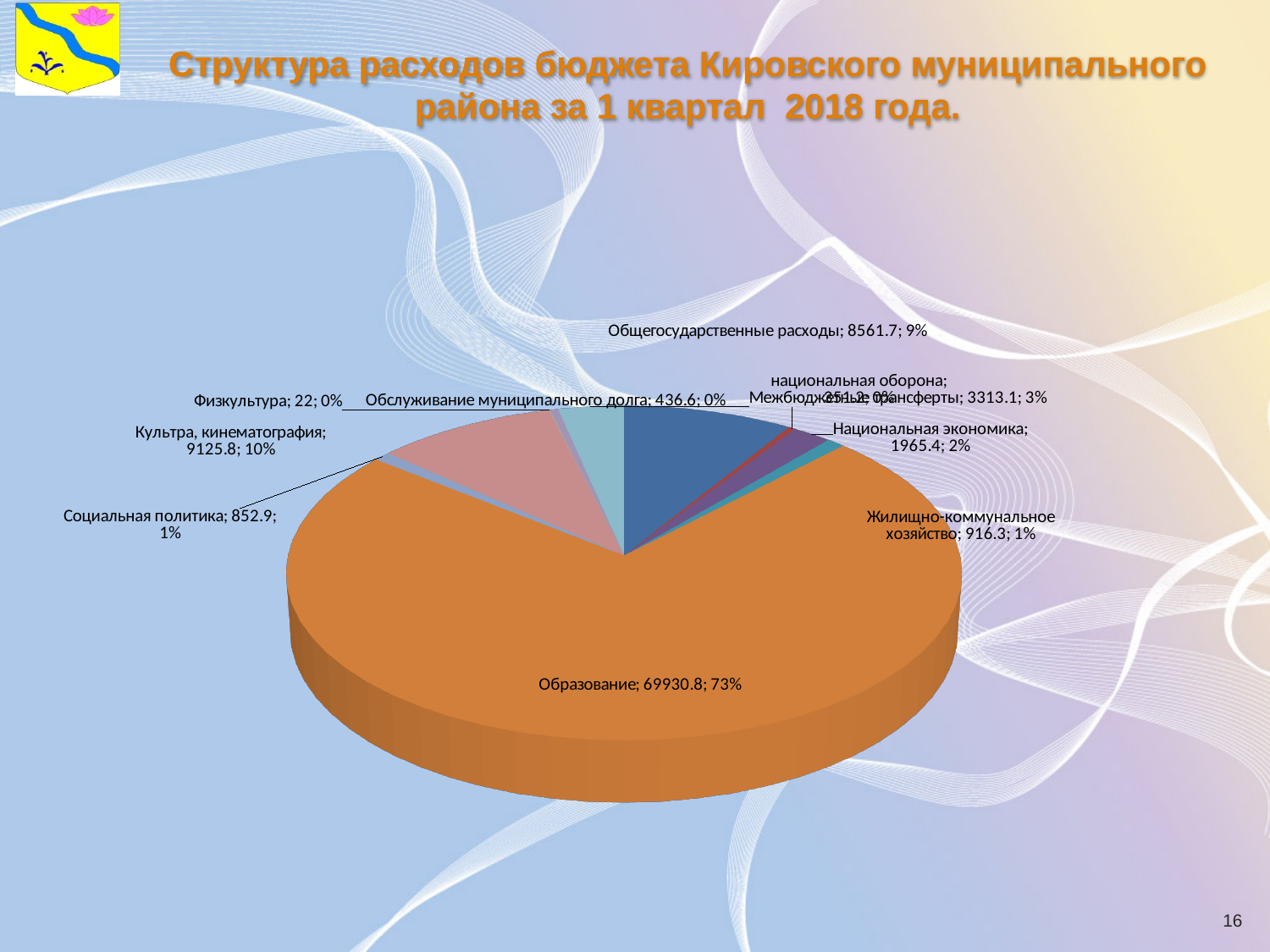
What is the value for Общегосударственные расходы? 8561.7 What is the value for Жилищно-коммунальное хозяйство? 916.3 Which category has the largest slice of the pie? Образование Which is larger: Межбюджетные трансферты or Национальная экономика? Межбюджетные трансферты What kind of chart is shown on the slide? Pie chart What is the value for Культра, кинематография? 9125.8 What is the value for Межбюджетные трансферты? 3313.1 What is the value for Образование? 69930.8 What is the difference between the values for Культра, кинематография and Общегосударственные расходы? 564.1 How many categories are shown in the pie chart? 10 What share of the pie does Образование take? 73% Which category has the smallest value? Физкультура